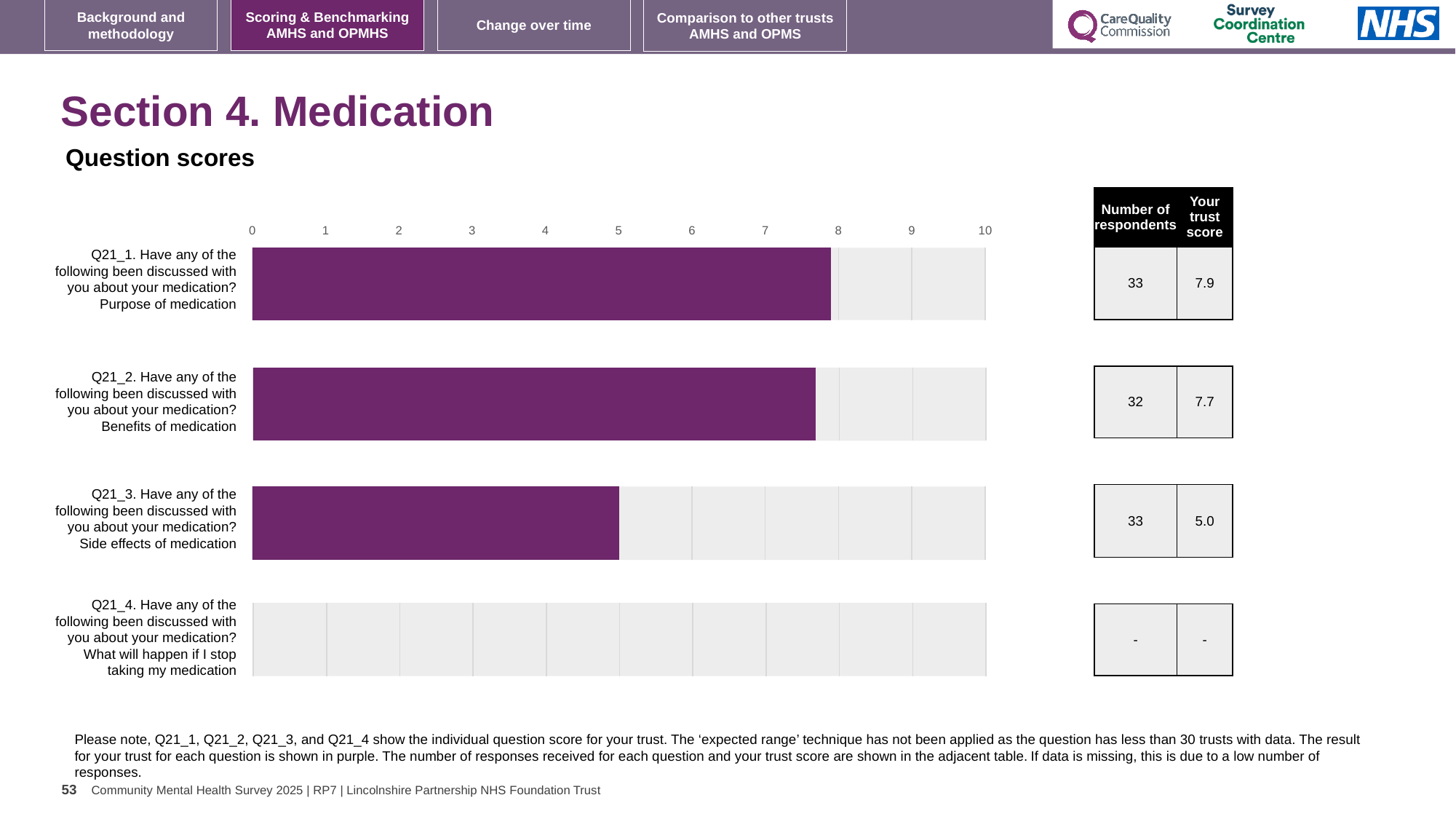
What is the difference between the trust scores for Q21_1 and Q21_3? 2.9 Is the trust score for Q21_2 (Benefits of medication) greater or less than 7? greater What type of chart is shown on the slide? Bar chart How many respondents answered Q21_2 (Benefits of medication)? 32 Which has a higher trust score, Q21_2 (Benefits of medication) or Q21_3 (Side effects of medication)? Q21_2 (Benefits of medication) Which question with a plotted score has the lowest trust score? Q21_3 (Side effects of medication) How many questions are listed on the chart? 4 Which question has no trust score shown (data missing)? Q21_4 (What will happen if I stop taking my medication) What is the maximum value shown on the chart's score axis? 10 What is the trust score for Q21_3 (Side effects of medication)? 5.0 Which question has the highest trust score on the chart? Q21_1 (Purpose of medication) What is the trust score for Q21_1 (Purpose of medication)? 7.9